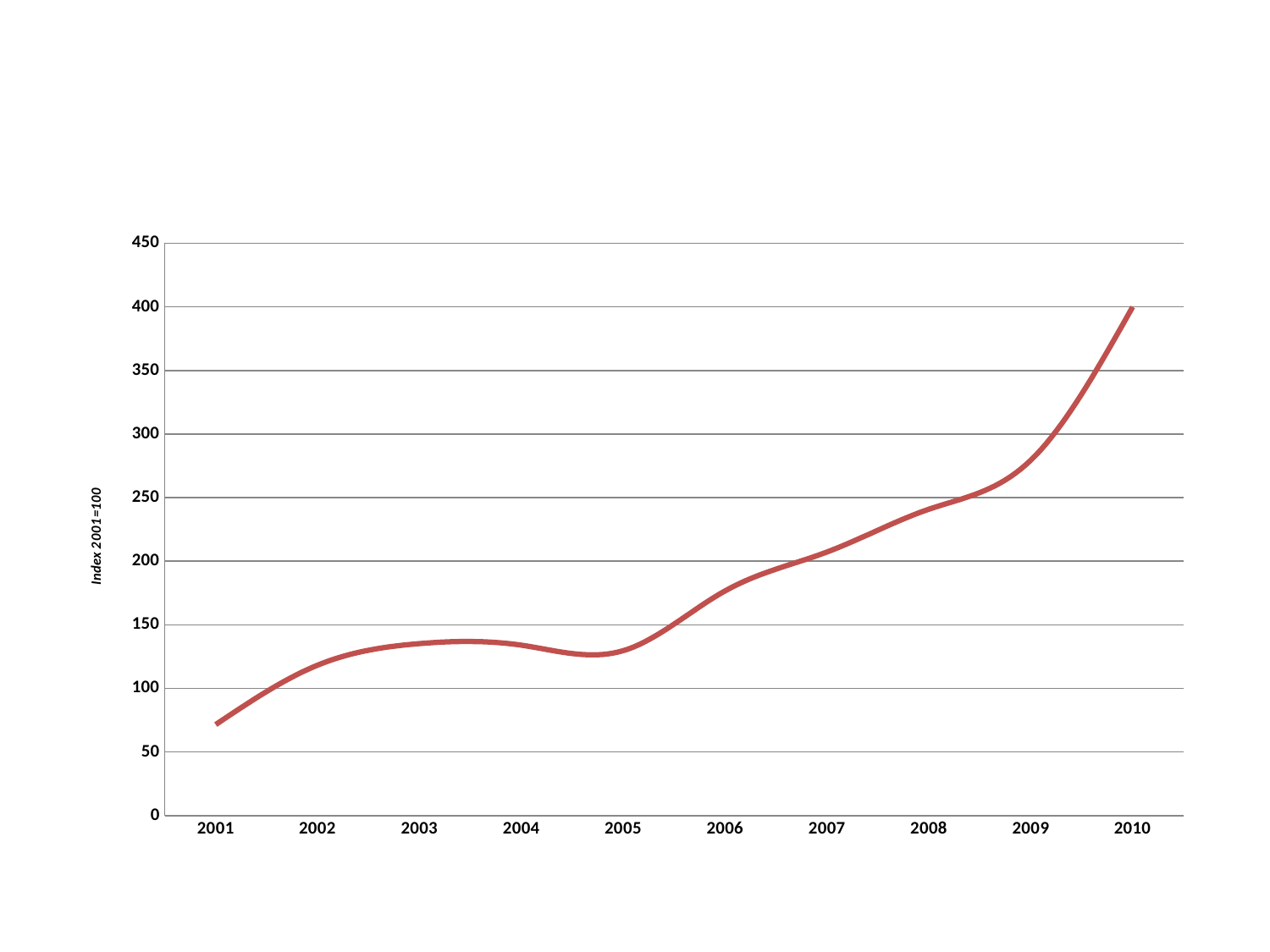
Which year has the lowest value on the line? 2001 Which year has the larger value, 2007 or 2005? 2007 Is the value for 2001 greater or less than 100? less Is the value for 2005 greater or less than 150? less What kind of chart is shown on the slide? line chart Is the value for 2009 greater or less than 250? greater How many years are plotted along the x axis? 10 What is the label on the vertical axis? Index 2001=100 Overall, does the line rise or fall from 2001 to 2010? rise Which year has the highest value on the line? 2010